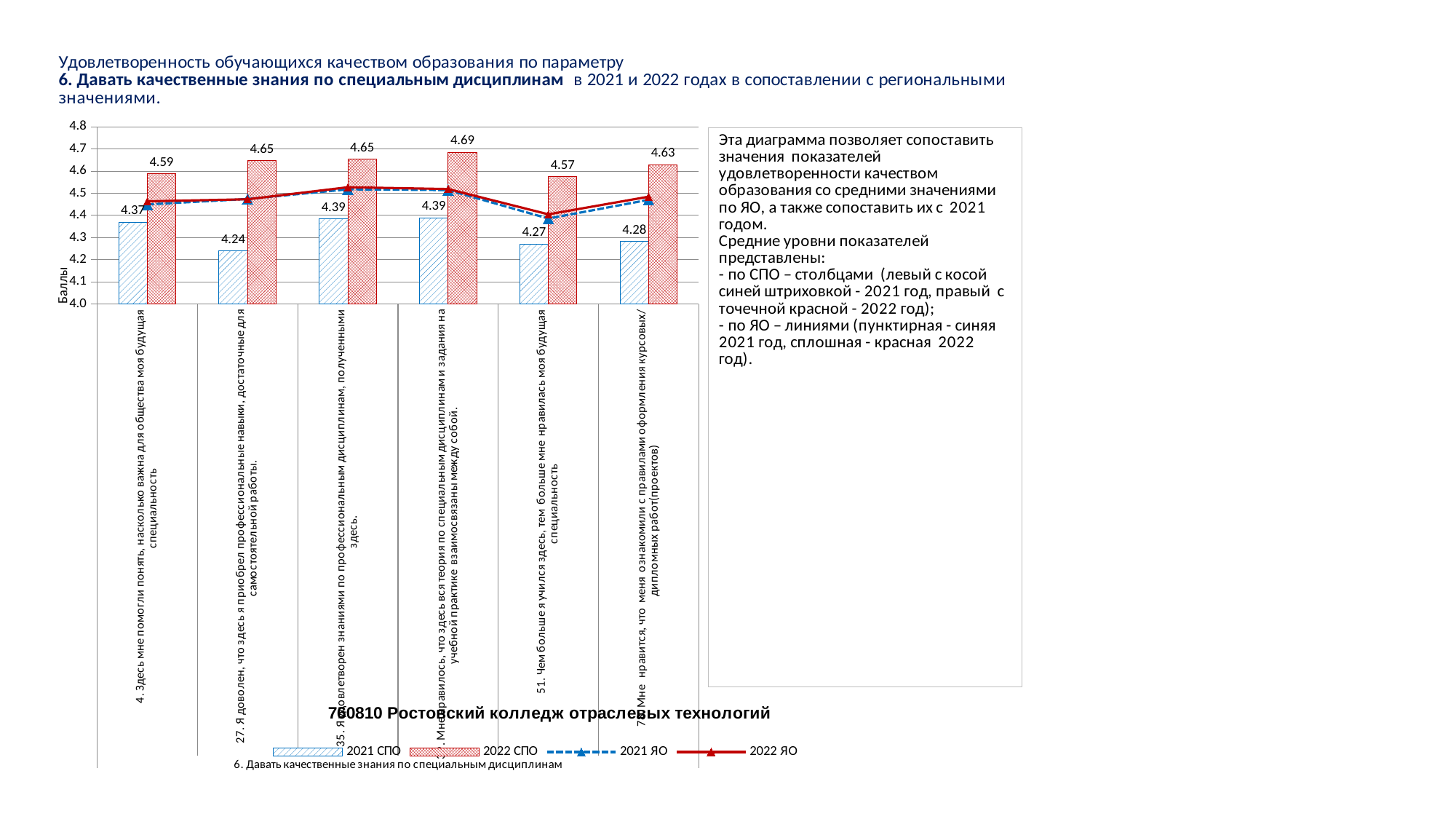
What is the 2021 СПО value for the category "51. Чем больше я учился здесь, тем больше мне нравилась моя будущая специальность"? 4.27 What kind of chart is shown on the slide? Combination bar and line chart How many categories are shown on the x axis of the chart? 6 What is the difference between the 2022 СПО and 2021 СПО values for the category "51. Чем больше я учился здесь, тем больше мне нравилась моя будущая специальность"? 0.30 Is the 2022 ЯО line value for the category "51. Чем больше я учился здесь, тем больше мне нравилась моя будущая специальность" greater or less than 4.5? less What is the 2022 СПО value for the category "4. Здесь мне помогли понять, насколько важна для общества моя будущая специальность"? 4.59 Which is larger: the 2021 СПО value for category 4 or for category 27? Category 4 (4.37) What is the 2022 СПО value for the category "27. Я доволен, что здесь я приобрел профессиональные навыки, достаточные для самостоятельной работы"? 4.65 Which category has the lowest 2021 СПО value? 27. Я доволен, что здесь я приобрел профессиональные навыки, достаточные для самостоятельной работы (4.24) How many series does the chart legend list? 4 What is the difference between the 2022 СПО and 2021 СПО values for the category "4. Здесь мне помогли понять, насколько важна для общества моя будущая специальность"? 0.22 Which category has the highest 2022 СПО value? Мне нравилось, что здесь вся теория по специальным дисциплинам и задания на учебной практике взаимосвязаны между собой (4.69)